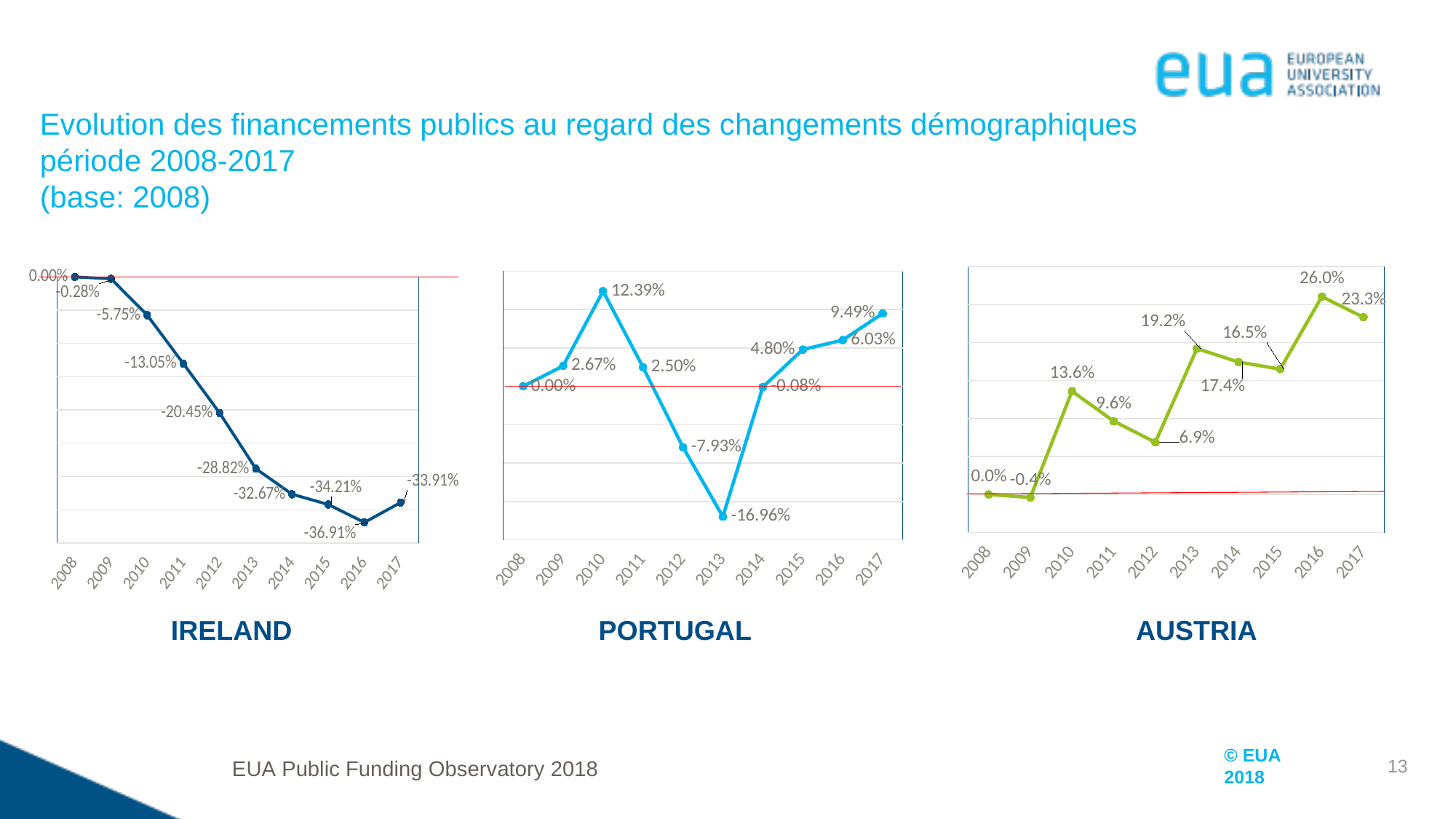
What kind of chart is the PORTUGAL chart? line chart In the IRELAND chart, which year has the lowest value? 2016 In the IRELAND chart, what is the value for 2016? -36.91% In the IRELAND chart, do the values rise or fall from 2008 to 2016? fall How many years are plotted on the x axis of the AUSTRIA chart? 10 In the PORTUGAL chart, what is the difference between the 2010 value and the 2017 value? 2.90% In the AUSTRIA chart, what is the value for 2013? 19.2% In the IRELAND chart, is the value for 2013 larger or smaller than the value for 2014? larger In the PORTUGAL chart, what is the value for 2010? 12.39% In the PORTUGAL chart, which year has the lowest value? 2013 In the AUSTRIA chart, which year has the highest value? 2016 In the AUSTRIA chart, what is the difference between the 2016 value and the 2017 value? 2.7%